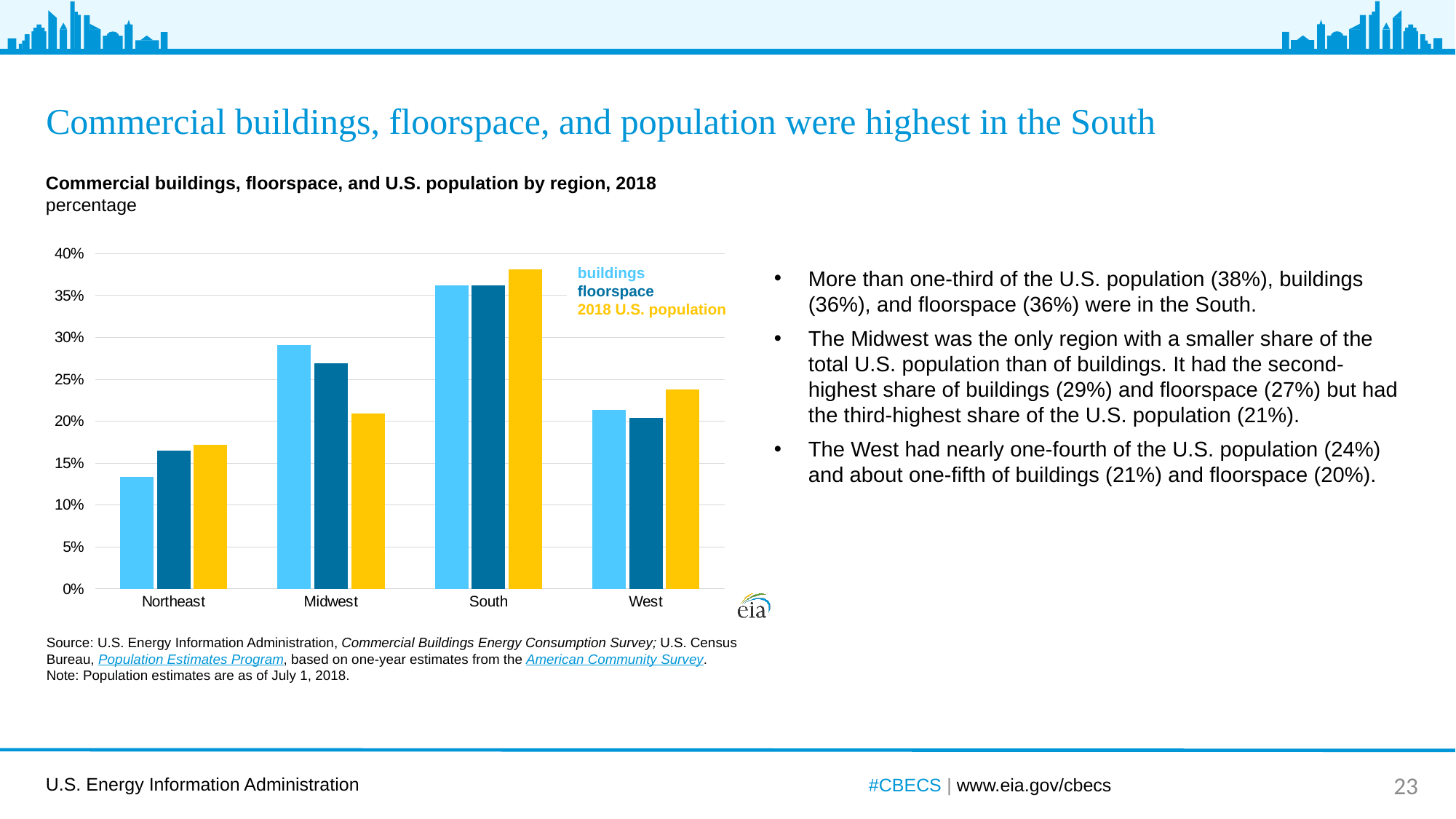
What kind of chart is shown on the slide? bar chart Which region has the lowest share of buildings? Northeast Is the value for 2018 U.S. population in the West greater or less than 20%? greater What is the difference between the Midwest's share of buildings and its share of the 2018 U.S. population? 8% How many regions are shown on the x axis of the chart? 4 Which region has the highest share of 2018 U.S. population? South Is the value for buildings in the Northeast greater or less than 15%? less What share of floorspace was in the West? 20% What share of buildings was in the Midwest? 29% What share of the 2018 U.S. population was in the South? 38% In the Midwest, which is larger: the share of buildings or the share of 2018 U.S. population? buildings How many series does the chart's legend list? 3